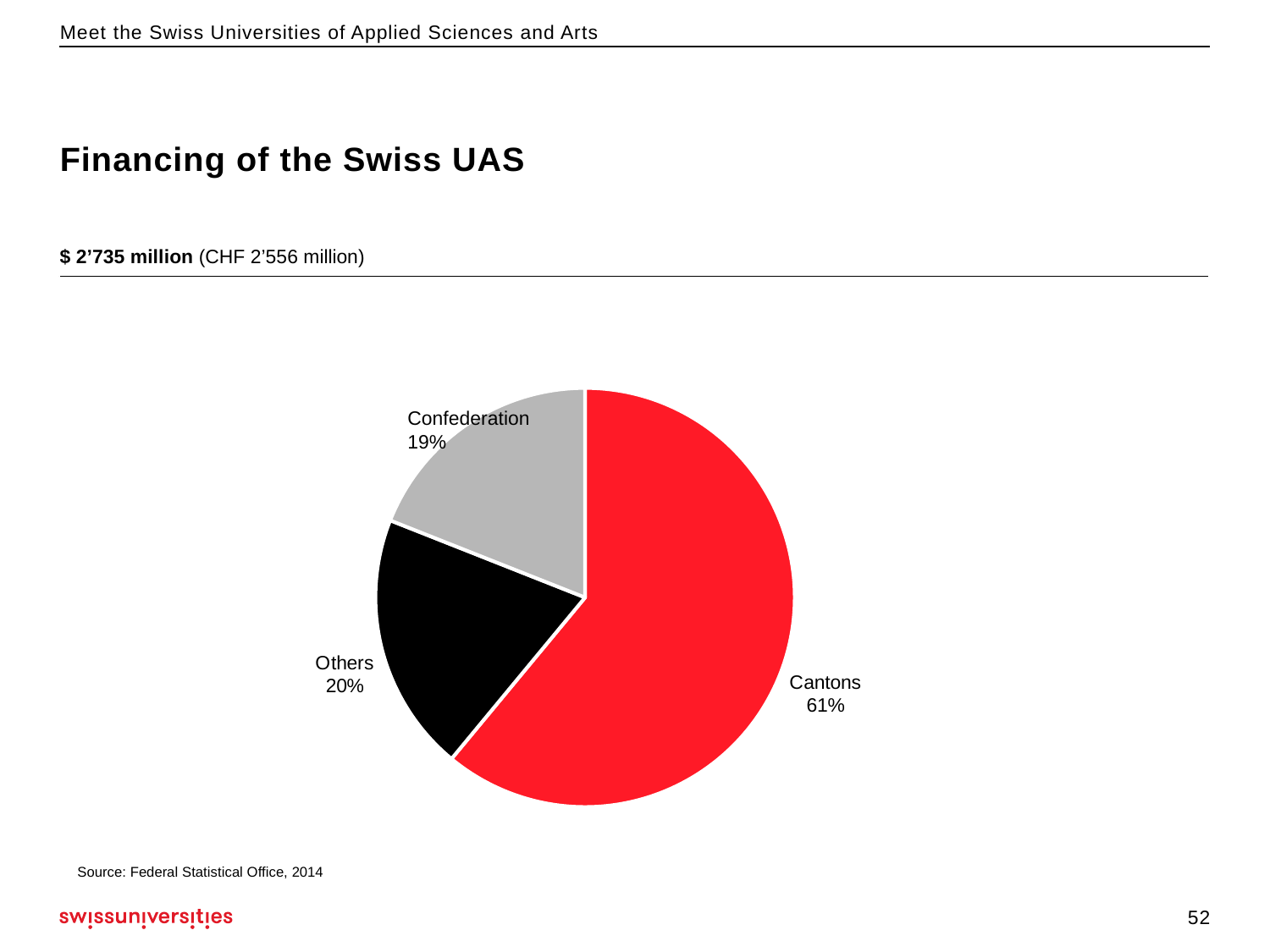
Which is larger, the share from Cantons or the share from Others? Cantons What share of the financing comes from Cantons? 61% What is the difference in percentage points between the Others share and the Confederation share? 1 What share of the financing comes from the Confederation? 19% What is the difference in percentage points between the Cantons share and the Others share? 41 What kind of chart is shown on the slide? Pie chart What colour is the Cantons slice? Red Which source provides the smallest share of financing? Confederation What total amount in dollars is stated above the chart? $ 2’735 million What share of the financing comes from Others? 20% Which source provides the largest share of financing? Cantons How many slices does the pie chart have? 3